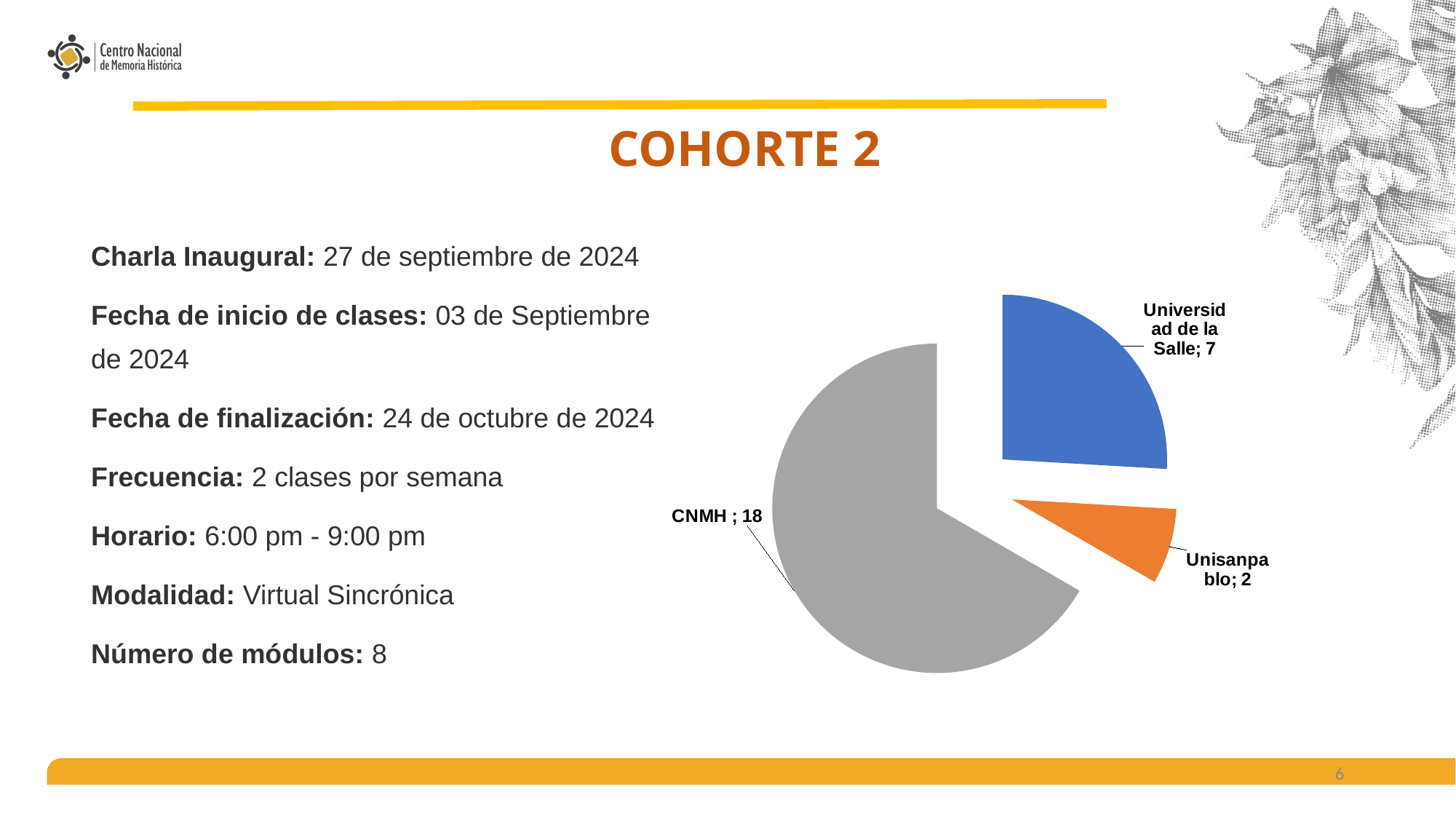
Which category has the smallest slice in the pie chart? Unisanpablo Which category has the largest slice in the pie chart? CNMH What is the value for Unisanpablo in the pie chart? 2 What colour is the CNMH slice in the pie chart? grey How many slices does the pie chart have? 3 What is the difference between the values for Universidad de la Salle and Unisanpablo? 5 What kind of chart is shown on the slide? pie chart What is the value for CNMH in the pie chart? 18 Which is larger, the value for Universidad de la Salle or the value for Unisanpablo? Universidad de la Salle What is the total of all the slices in the pie chart? 27 What is the difference between the values for CNMH and Universidad de la Salle? 11 What is the value for Universidad de la Salle in the pie chart? 7